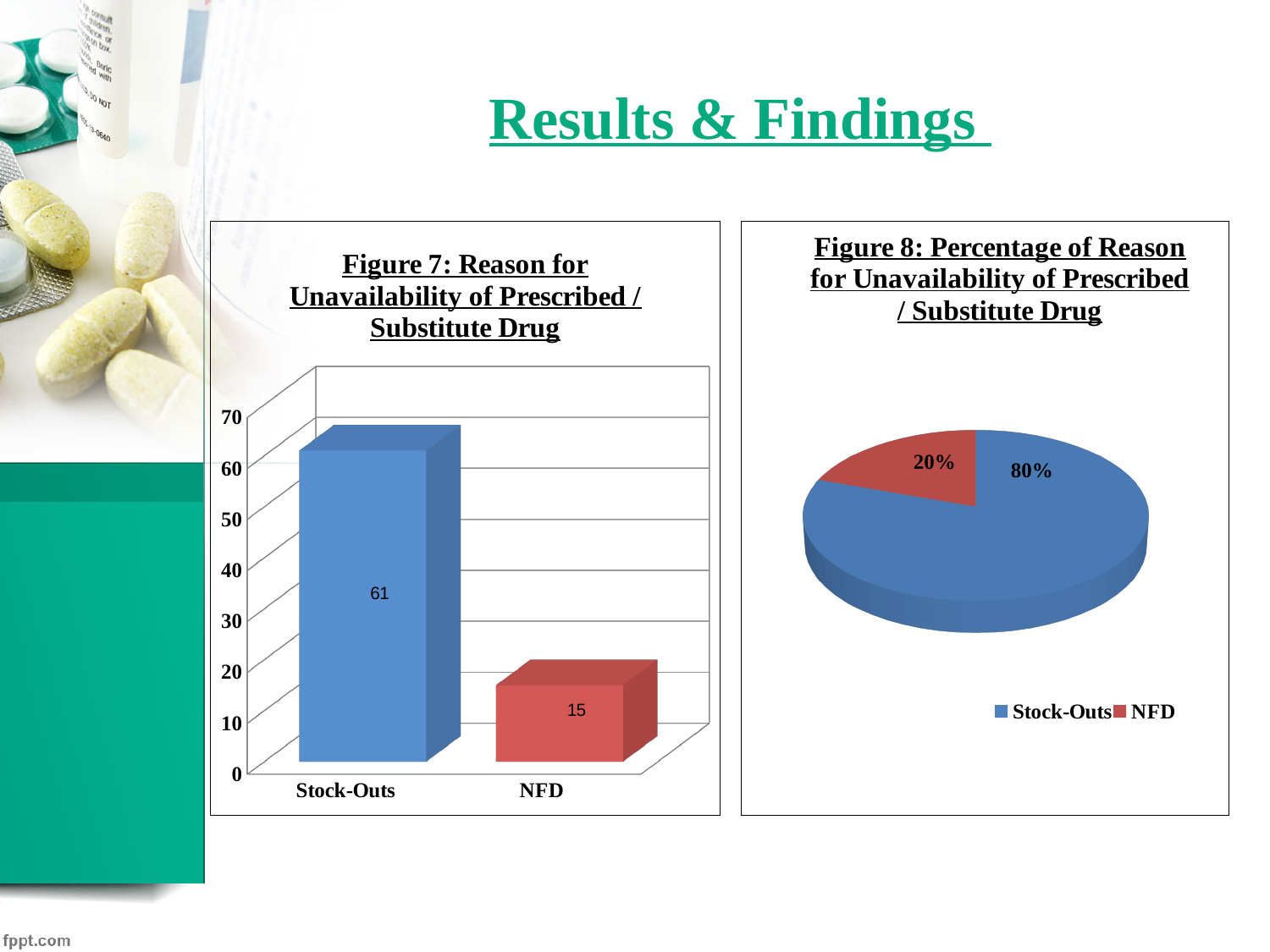
What kind of chart is Figure 7? Bar chart In Figure 7, which category has the highest value? Stock-Outs In Figure 8, what percentage does the NFD slice represent? 20% What kind of chart is Figure 8? Pie chart In Figure 8, how many entries does the legend list? 2 In Figure 7, what is the value for NFD? 15 In Figure 7, how many categories are shown on the x axis? 2 In Figure 7, what is the value for Stock-Outs? 61 In Figure 8, what percentage does the Stock-Outs slice represent? 80% In Figure 7, which category has the lowest value? NFD In Figure 8, which slice is larger, Stock-Outs or NFD? Stock-Outs In Figure 7, what is the difference between the values for Stock-Outs and NFD? 46